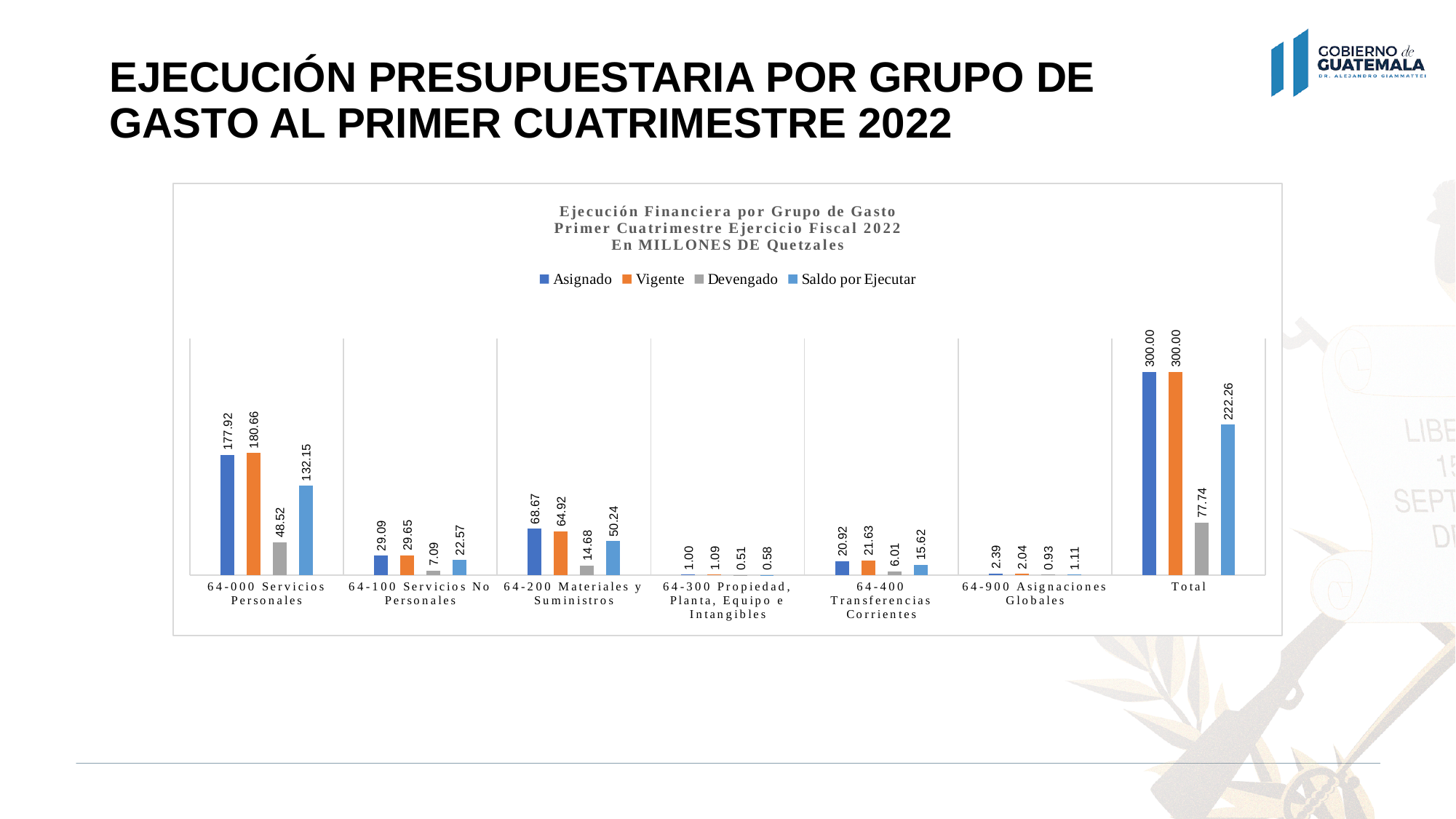
Which category has the lowest Vigente value? 64-300 Propiedad, Planta, Equipo e Intangibles What is the Devengado value for 64-200 Materiales y Suministros? 14.68 How many series does the legend list? 4 What unit does the chart title say the values are in? Millones de Quetzales What is the Vigente value for 64-000 Servicios Personales? 180.66 What is the Asignado value for 64-400 Transferencias Corrientes? 20.92 How many categories are shown on the x axis? 7 Excluding Total, which category has the highest Devengado value? 64-000 Servicios Personales What is the difference between the Vigente and Devengado values for 64-100 Servicios No Personales? 22.56 Which is larger for 64-200 Materiales y Suministros, Asignado or Vigente? Asignado What kind of chart is shown on the slide? Bar chart What is the Saldo por Ejecutar value for Total? 222.26